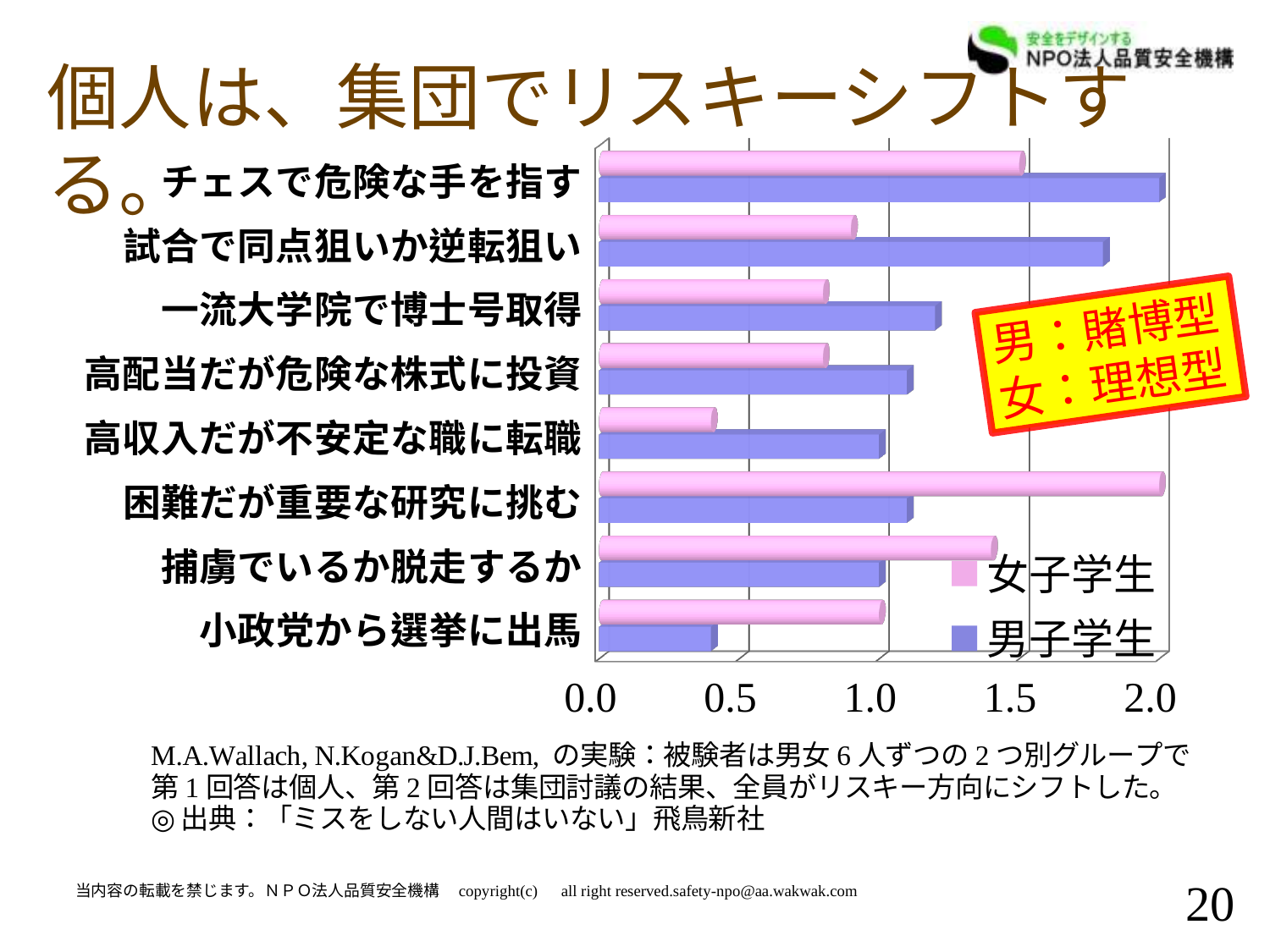
Is the value for 男子学生 in 小政党から選挙に出馬 greater or less than 0.5? less In 捕虜でいるか脱走するか, which series has the larger value, 女子学生 or 男子学生? 女子学生 Is the value for 男子学生 in 試合で同点狙いか逆転狙い greater or less than 1.5? greater Is the value for 女子学生 in 高収入だが不安定な職に転職 greater or less than 0.5? less How many series does the chart's legend list? 2 Which category has the highest value for 女子学生? 困難だが重要な研究に挑む How many categories are plotted on the chart? 8 Which series is shown in pink in the legend? 女子学生 In チェスで危険な手を指す, which series has the larger value, 女子学生 or 男子学生? 男子学生 Which category has the lowest value for 男子学生? 小政党から選挙に出馬 What kind of chart is shown on the slide? bar chart